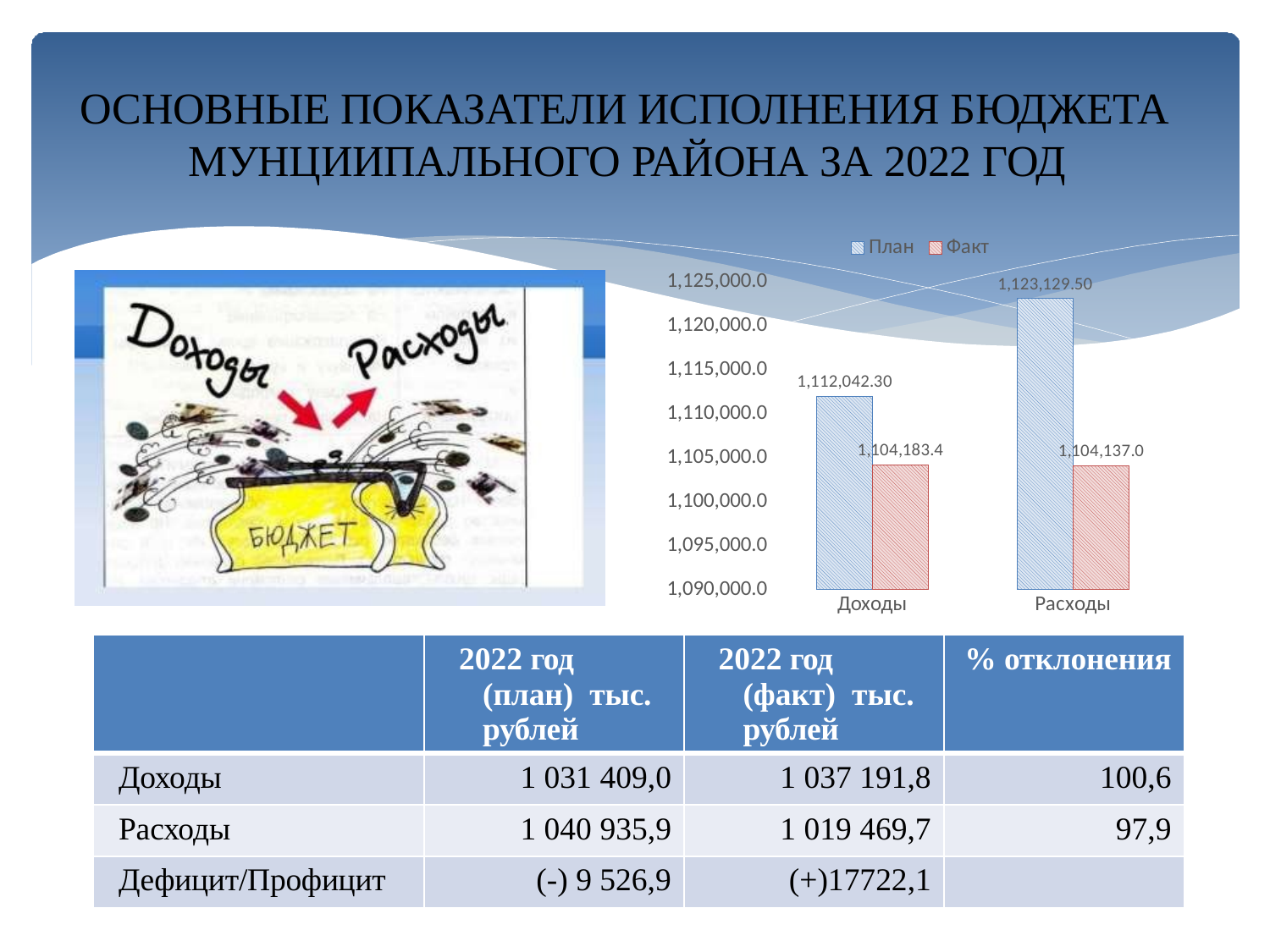
What is the Факт value for Расходы in the chart? 1,104,137.0 Which bar in the chart is the highest? Расходы, План What is the План value for Доходы in the chart? 1,112,042.30 What is the difference between the План values for Расходы and Доходы in the chart? 11,087.20 How many categories are shown on the x axis of the chart? 2 In the chart, which is larger for Расходы: the План value or the Факт value? План What type of chart is shown on the slide? Bar chart How many series does the chart legend list? 2 What is the difference between the План and Факт values for Расходы in the chart? 18,992.5 Is the План value for Расходы in the chart greater or less than 1,120,000.0? greater What is the Факт value for Доходы in the chart? 1,104,183.4 What is the План value for Расходы in the chart? 1,123,129.50